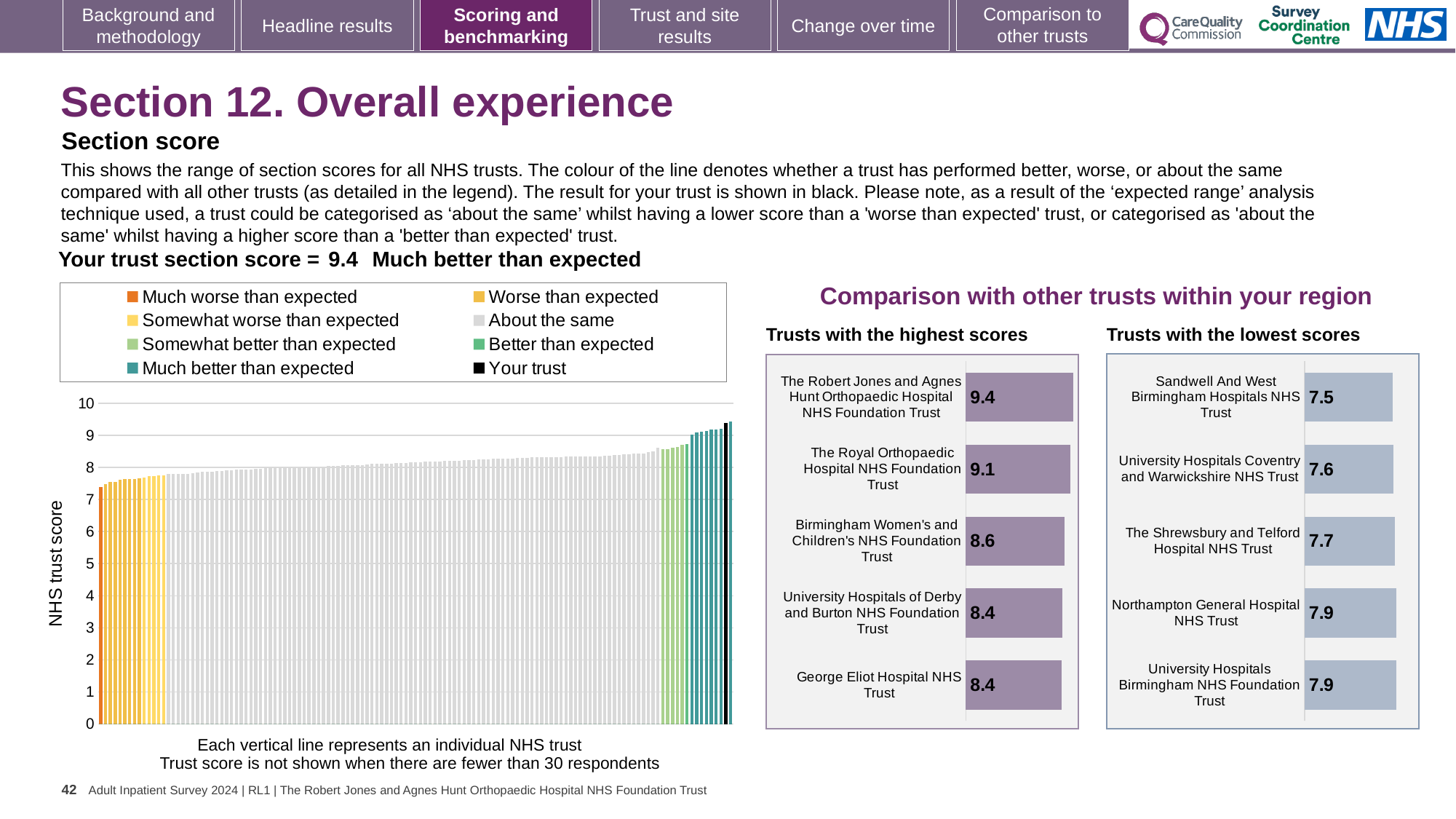
In the 'Trusts with the highest scores' chart, what is the score for The Royal Orthopaedic Hospital NHS Foundation Trust? 9.1 In the 'Trusts with the highest scores' chart, which has the larger score: The Royal Orthopaedic Hospital NHS Foundation Trust or Birmingham Women's and Children's NHS Foundation Trust? The Royal Orthopaedic Hospital NHS Foundation Trust In the 'Trusts with the highest scores' chart, which trust has the highest score? The Robert Jones and Agnes Hunt Orthopaedic Hospital NHS Foundation Trust What is the difference between the score of The Robert Jones and Agnes Hunt Orthopaedic Hospital NHS Foundation Trust in the highest scores chart and Sandwell And West Birmingham Hospitals NHS Trust in the lowest scores chart? 1.9 What kind of chart is the main chart showing the range of section scores for all NHS trusts? Bar chart How many entries does the legend of the main 'NHS trust score' chart list? 8 In the main 'NHS trust score' chart, do the trust scores rise or fall from left to right? Rise In the 'Trusts with the lowest scores' chart, what is the score for The Shrewsbury and Telford Hospital NHS Trust? 7.7 In the 'Trusts with the lowest scores' chart, which trust has the lowest score? Sandwell And West Birmingham Hospitals NHS Trust In the 'Trusts with the lowest scores' chart, how many trusts are shown? 5 In the main 'NHS trust score' chart, is the lowest trust score greater or less than 7? greater In the main 'NHS trust score' chart, what colour does the legend use for 'Your trust'? Black